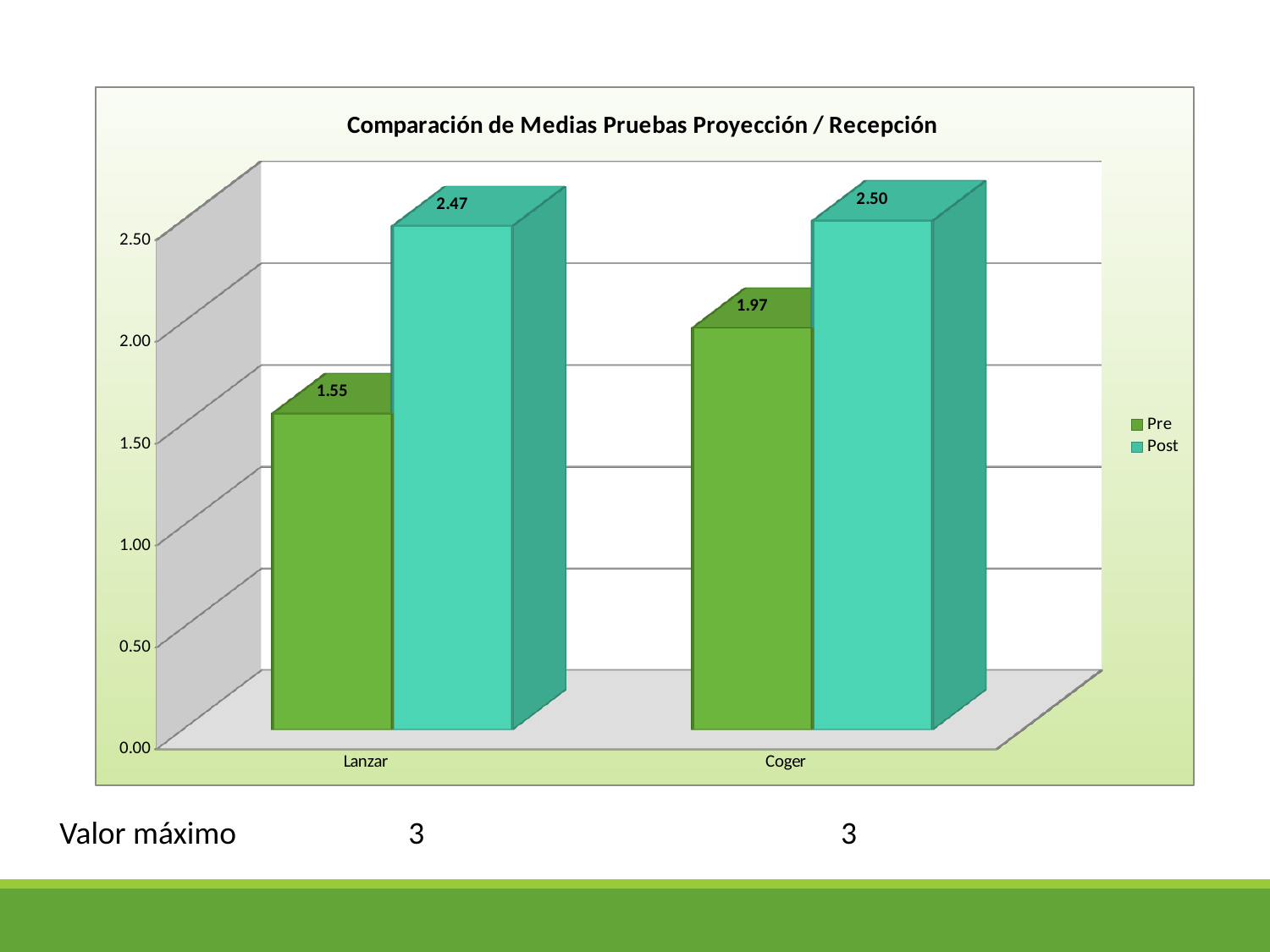
What is the difference between the Pre values for Coger and Lanzar? 0.42 Which category has the lowest Pre value? Lanzar What is the Pre value for Lanzar? 1.55 What type of chart is shown on the slide? bar chart Which is larger, the Pre value for Coger or the Pre value for Lanzar? Coger What is the Pre value for Coger? 1.97 What is the Post value for Coger? 2.50 What is the Post value for Lanzar? 2.47 What is the difference between the Post and Pre values for Lanzar? 0.92 How many series does the legend list? 2 Is the Pre value for Coger greater or less than 2.00? less How many categories are shown on the x axis? 2